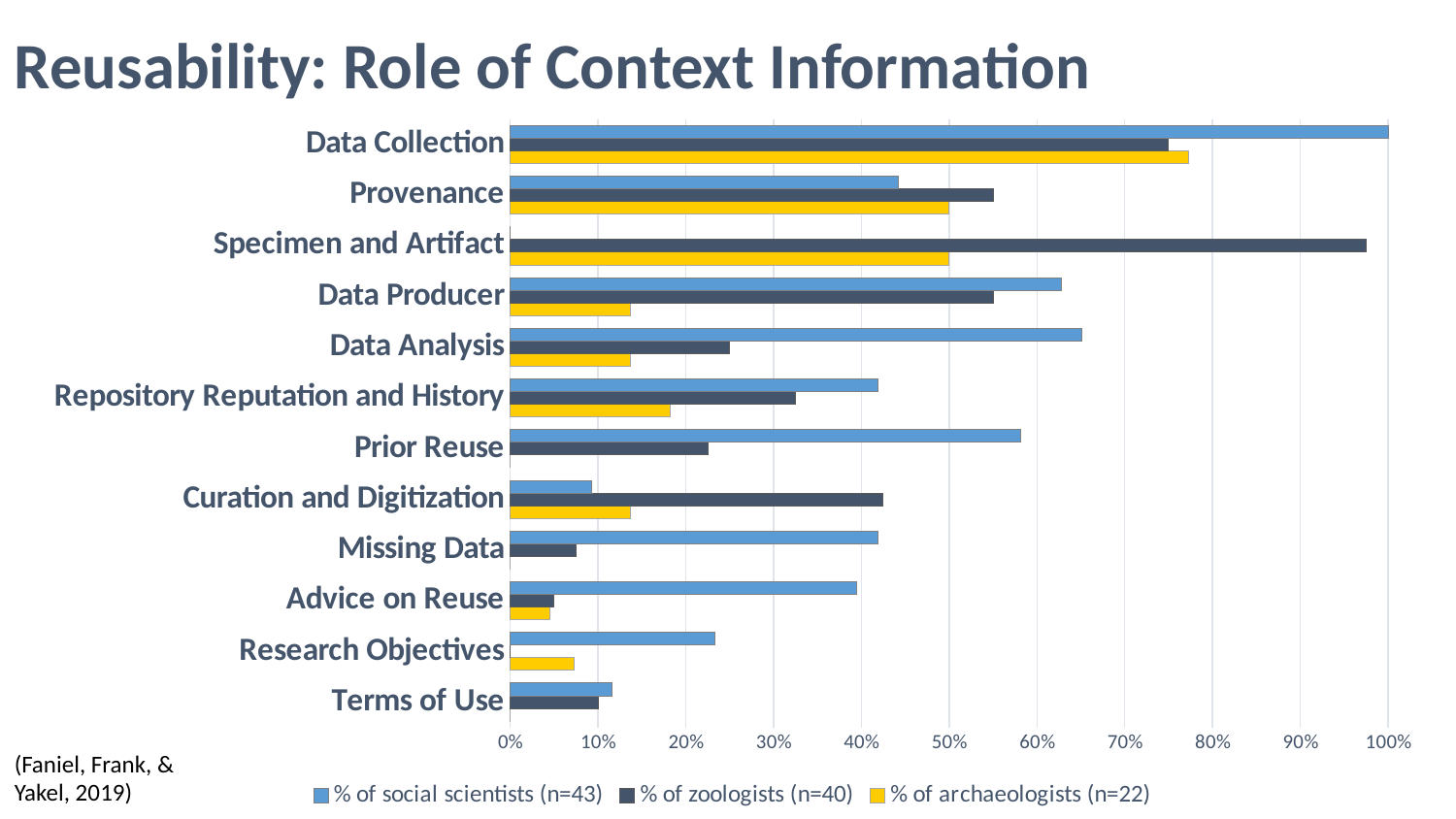
For Prior Reuse, which is larger: % of social scientists (n=43) or % of zoologists (n=40)? % of social scientists (n=43) For Curation and Digitization, which is larger: % of zoologists (n=40) or % of social scientists (n=43)? % of zoologists (n=40) What colour represents % of archaeologists (n=22) in the chart? yellow Is the value for % of archaeologists (n=22) for Data Producer greater or less than 20%? less How many series does the legend list? 3 Which category has the highest value for % of zoologists (n=40)? Specimen and Artifact Is the value for % of zoologists (n=40) for Specimen and Artifact greater or less than 90%? greater Is the value for % of social scientists (n=43) for Data Analysis greater or less than 60%? greater How many context information categories are plotted on the chart? 12 What is the value for % of social scientists (n=43) for Data Collection? 100% Which category has the highest value for % of social scientists (n=43)? Data Collection What kind of chart is shown on the slide? bar chart